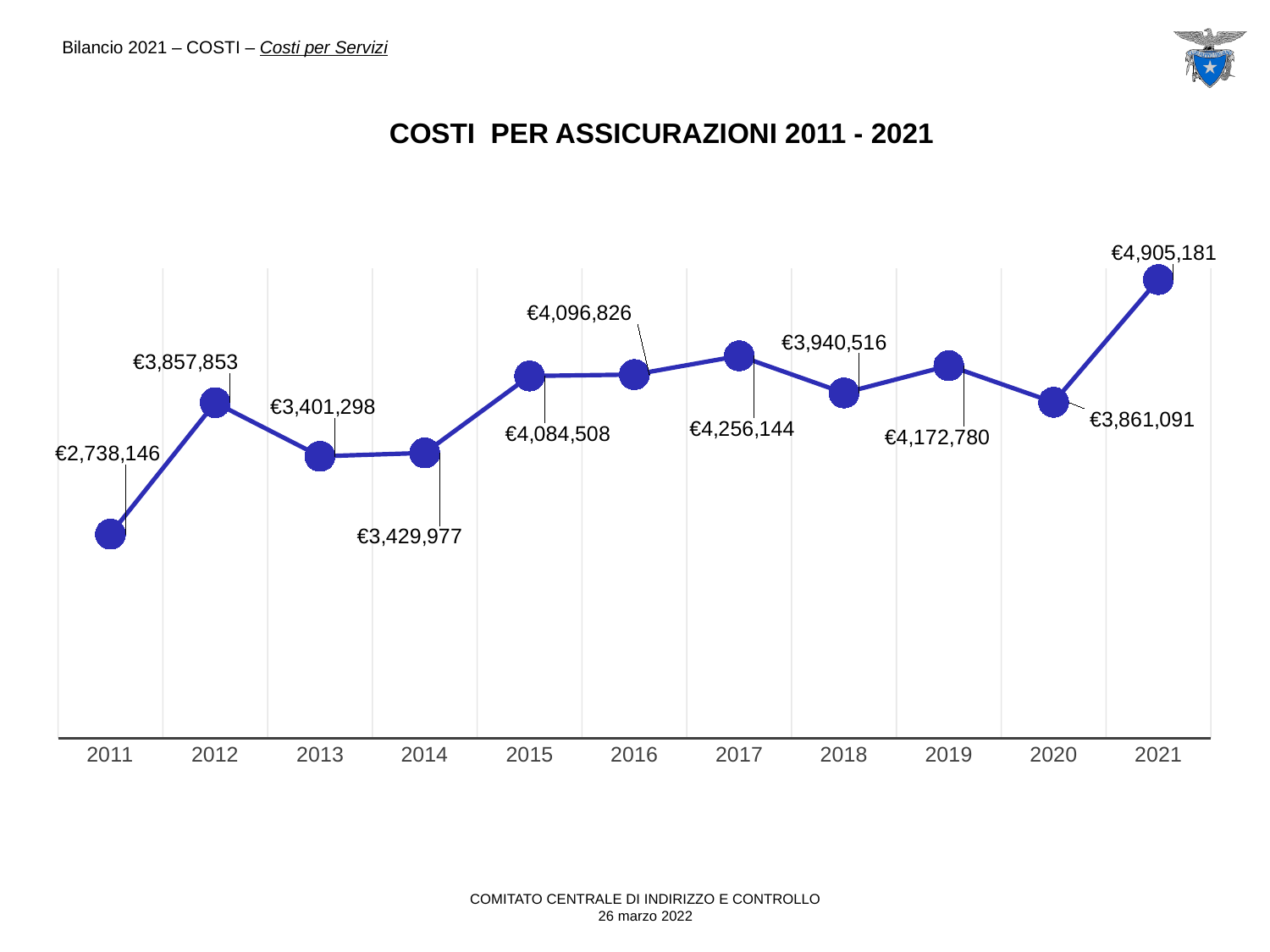
Which is larger, the value for 2019 or the value for 2018? 2019 What is the value for 2014? €3,429,977 Does the value rise or fall from 2017 to 2018? Fall What is the difference between the values for 2012 and 2013? €456,555 How many years are plotted on the chart? 11 What kind of chart is shown? Line chart Which year has the highest value? 2021 What is the difference between the values for 2021 and 2011? €2,167,035 What is the value for 2011? €2,738,146 Which year has the lowest value? 2011 What is the value for 2017? €4,256,144 What is the value for 2020? €3,861,091